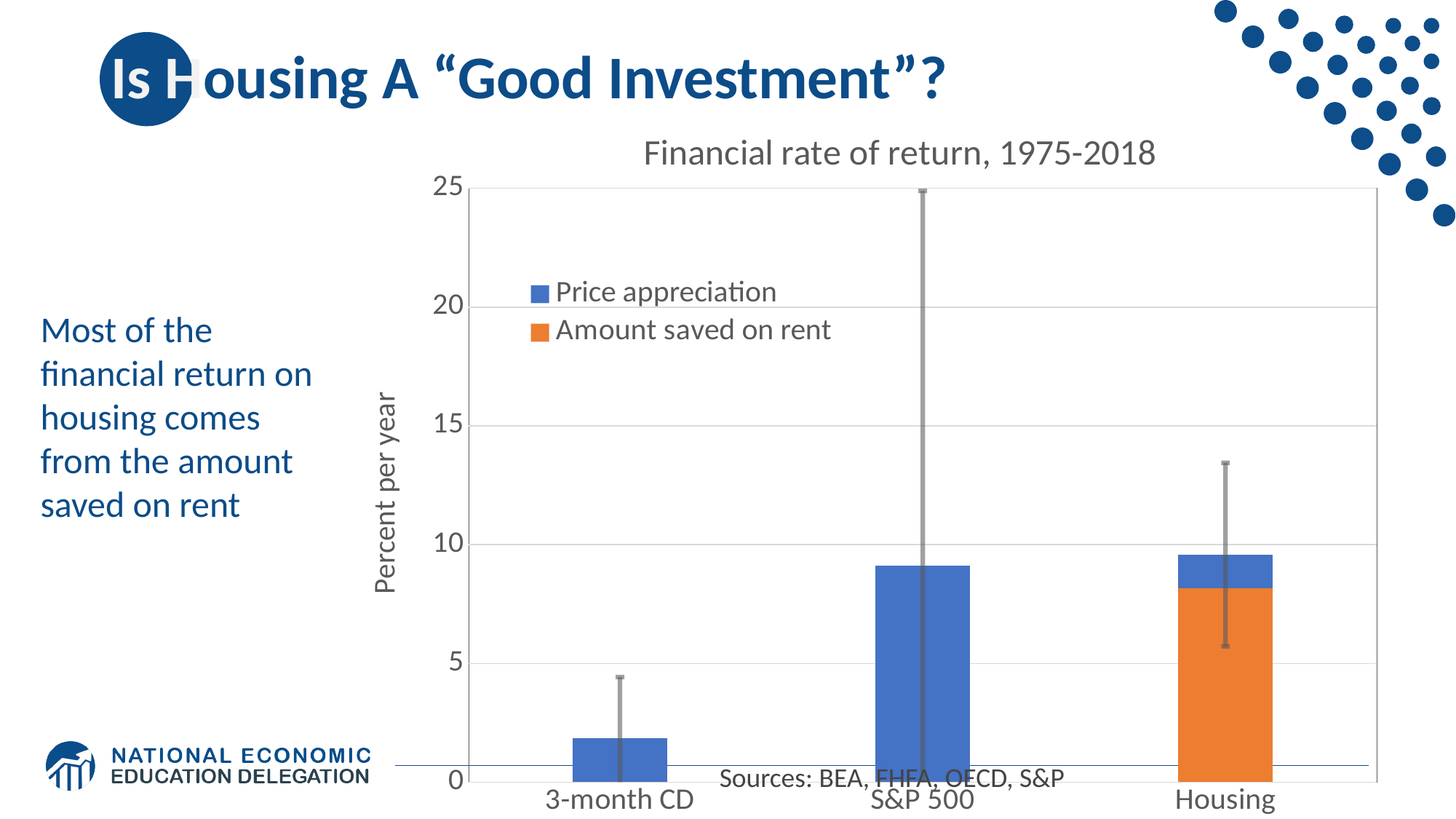
Is the value for 3-month CD greater or less than 5? less How many series does the chart's legend list? 2 Which is larger, the value for S&P 500 or the value for 3-month CD? S&P 500 Is the total value for Housing greater or less than 5? greater Which category is the only one with an 'Amount saved on rent' segment? Housing Which category has the lowest total financial rate of return? 3-month CD Is the value for S&P 500 greater or less than 5? greater What kind of chart is shown on the slide? Stacked bar chart Which series is shown in orange in the chart? Amount saved on rent What is the title of the chart? Financial rate of return, 1975-2018 How many categories are shown on the x axis of the chart? 3